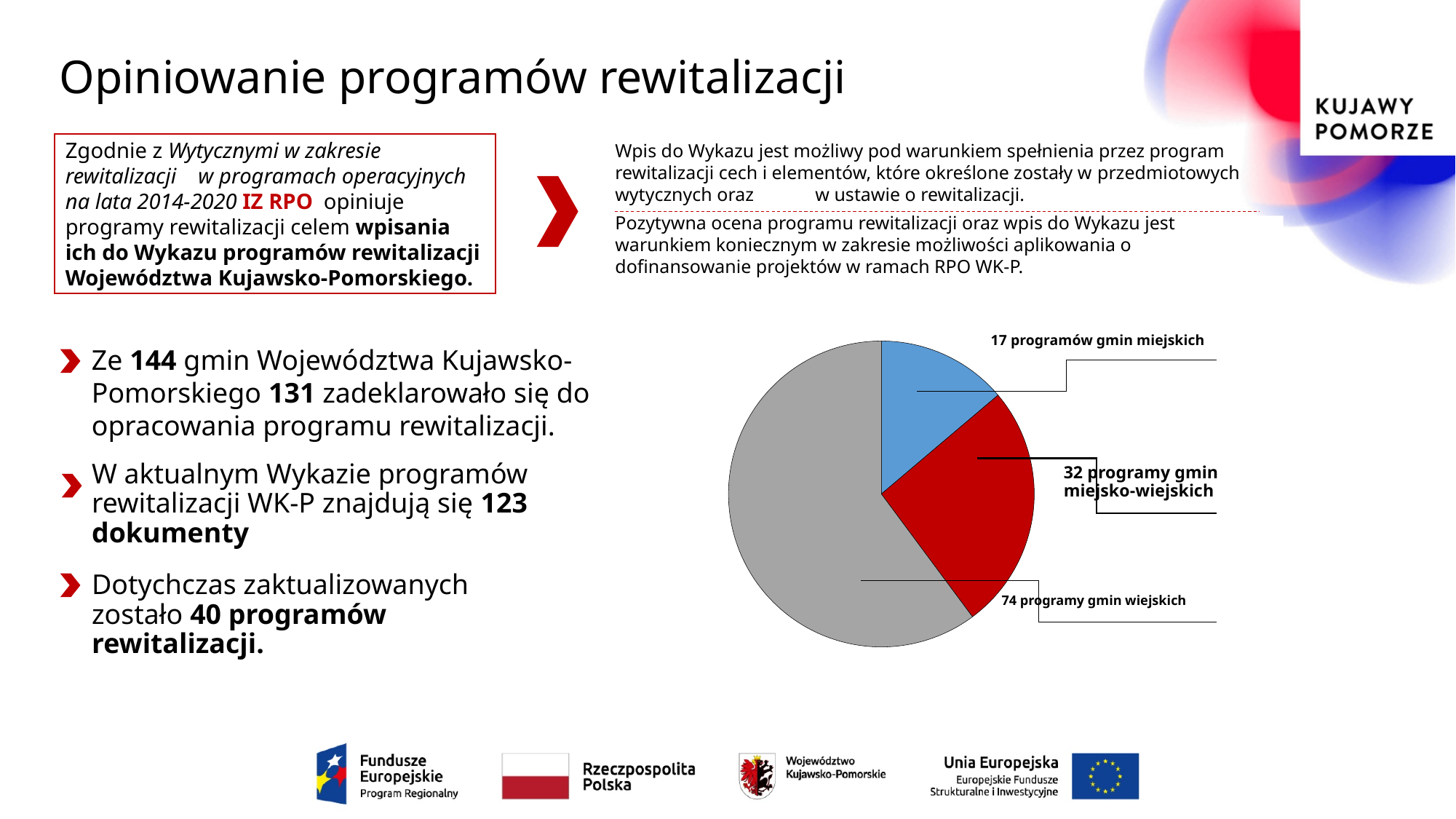
Which category has the largest slice in the pie chart? programy gmin wiejskich What is the difference between the number of programs for gminy wiejskie and gminy miejskie? 57 What is the total number of programs across all three slices of the pie chart? 123 How many programs are shown for gminy wiejskie (rural municipalities) in the pie chart? 74 How many slices does the pie chart have? 3 Which category has the smallest slice in the pie chart? programów gmin miejskich What kind of chart is shown on the slide? pie chart How many programs are shown for gminy miejsko-wiejskie (urban-rural municipalities) in the pie chart? 32 Which is larger: the number of programs for gminy miejsko-wiejskie or for gminy miejskie? gminy miejsko-wiejskie How many programs are shown for gminy miejskie (urban municipalities) in the pie chart? 17 What colour is the slice representing 74 programy gmin wiejskich? grey What is the difference between the number of programs for gminy miejsko-wiejskie and gminy miejskie? 15